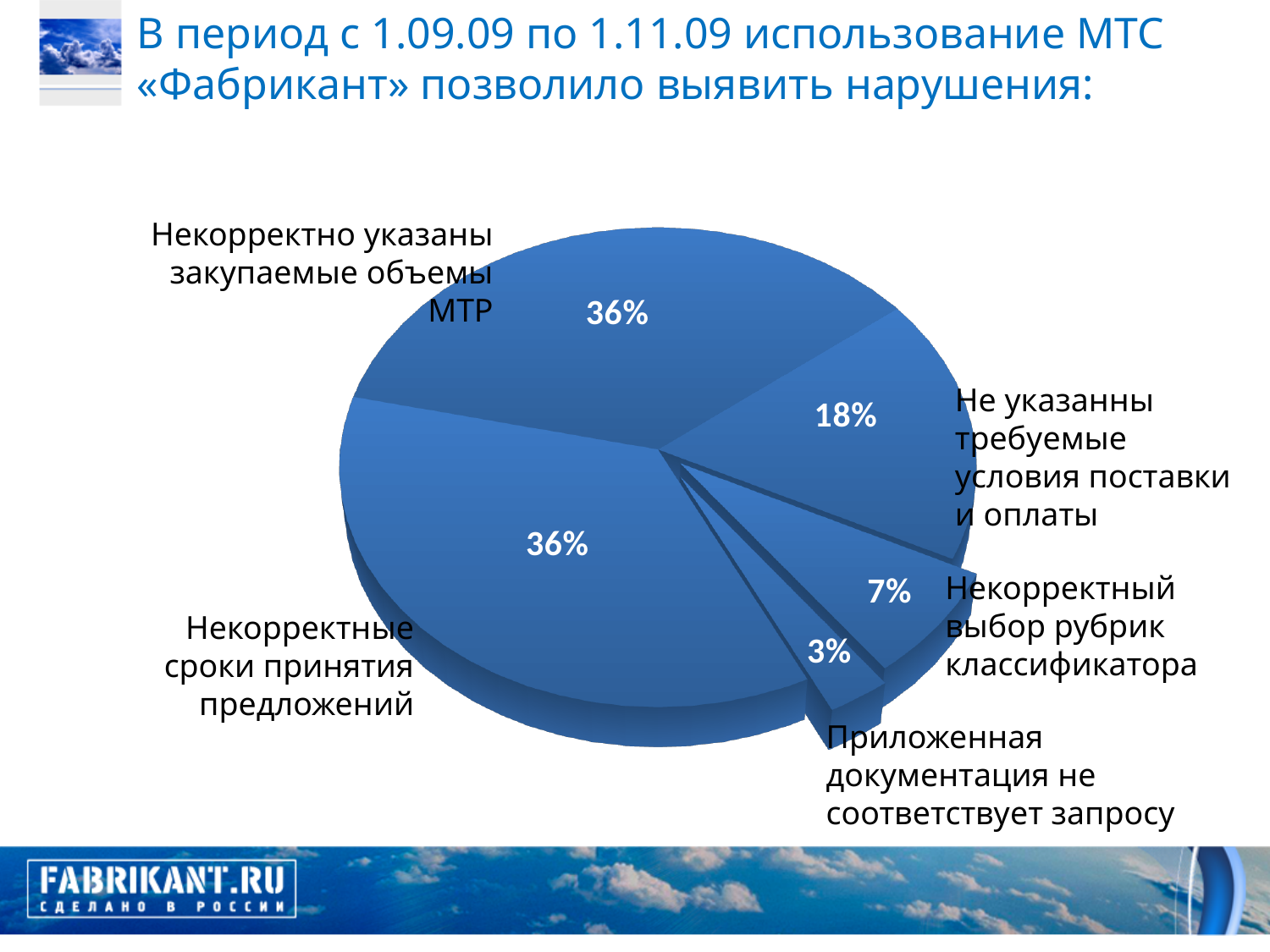
What is the difference in percentage points between the "Некорректные сроки принятия предложений" slice and the "Не указанны требуемые условия поставки и оплаты" slice? 18 What share of the pie is labelled "Некорректные сроки принятия предложений"? 36% What share of the pie is labelled "Не указанны требуемые условия поставки и оплаты"? 18% What kind of chart is shown on the slide? pie chart How many slices does the pie chart have? 5 What is the difference in percentage points between the "Некорректный выбор рубрик классификатора" slice and the "Приложенная документация не соответствует запросу" slice? 4 Which is larger: the slice for "Не указанны требуемые условия поставки и оплаты" or the slice for "Некорректный выбор рубрик классификатора"? Не указанны требуемые условия поставки и оплаты Which category has the smallest slice of the pie? Приложенная документация не соответствует запросу What share of the pie is labelled "Некорректный выбор рубрик классификатора"? 7% What share of the pie is labelled "Некорректно указаны закупаемые объемы МТР"? 36% What share of the pie is labelled "Приложенная документация не соответствует запросу"? 3% What is the combined share of the two slices labelled 36%? 72%